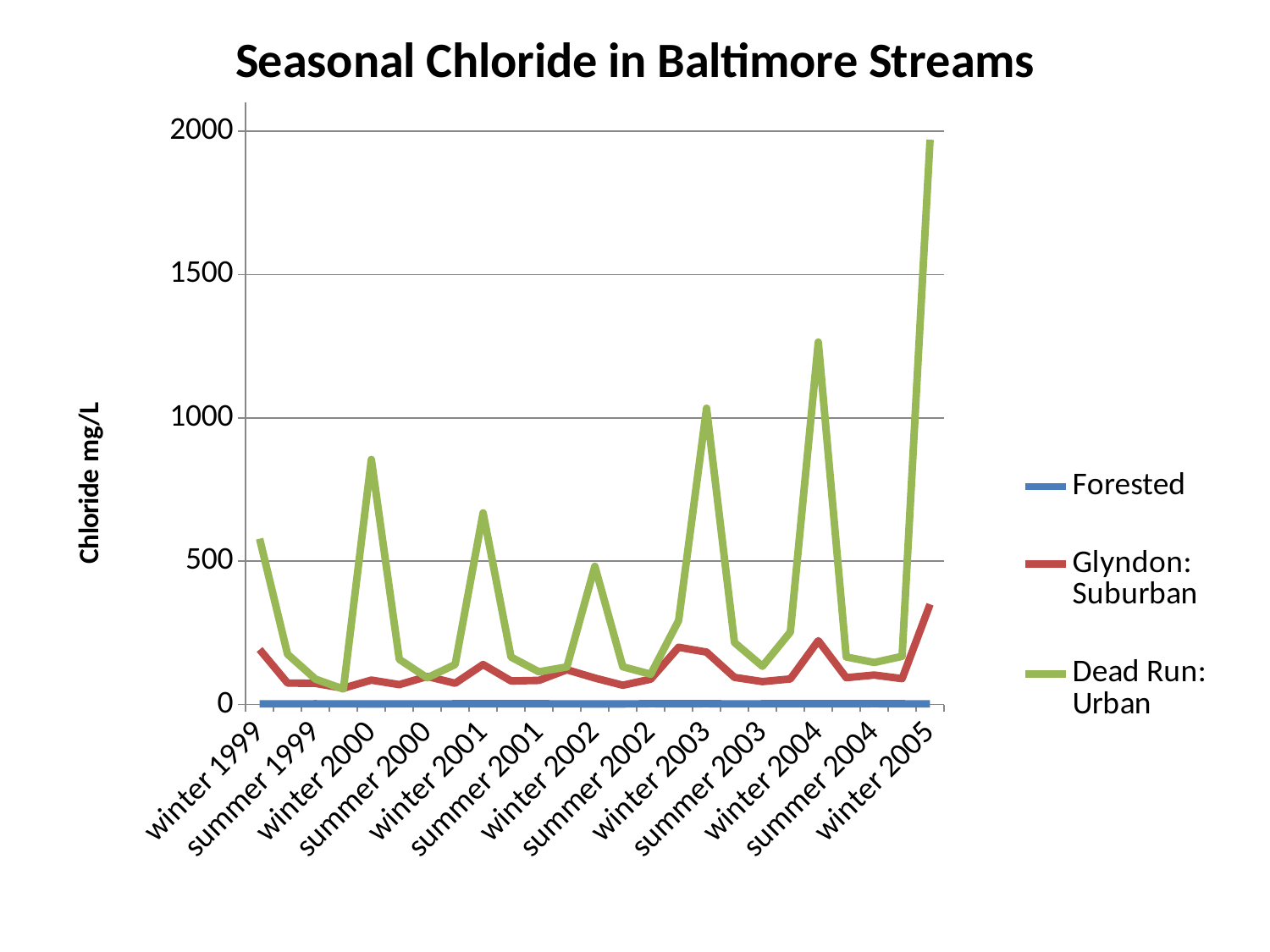
Which series has the lowest chloride values throughout the chart? Forested Is the Dead Run: Urban value for winter 2000 greater or less than 1000? less What is the title of the chart? Seasonal Chloride in Baltimore Streams At which season is the Dead Run: Urban value highest? winter 2005 What is the label on the vertical axis? Chloride mg/L Which series reaches the highest chloride value on the chart? Dead Run: Urban Is the Dead Run: Urban value for winter 2005 greater or less than 1500? greater What kind of chart is shown on the slide? line chart How many series does the legend list? 3 Is the Glyndon: Suburban value for winter 2005 greater or less than 500? less Which is larger at winter 2004, the Dead Run: Urban value or the Glyndon: Suburban value? Dead Run: Urban